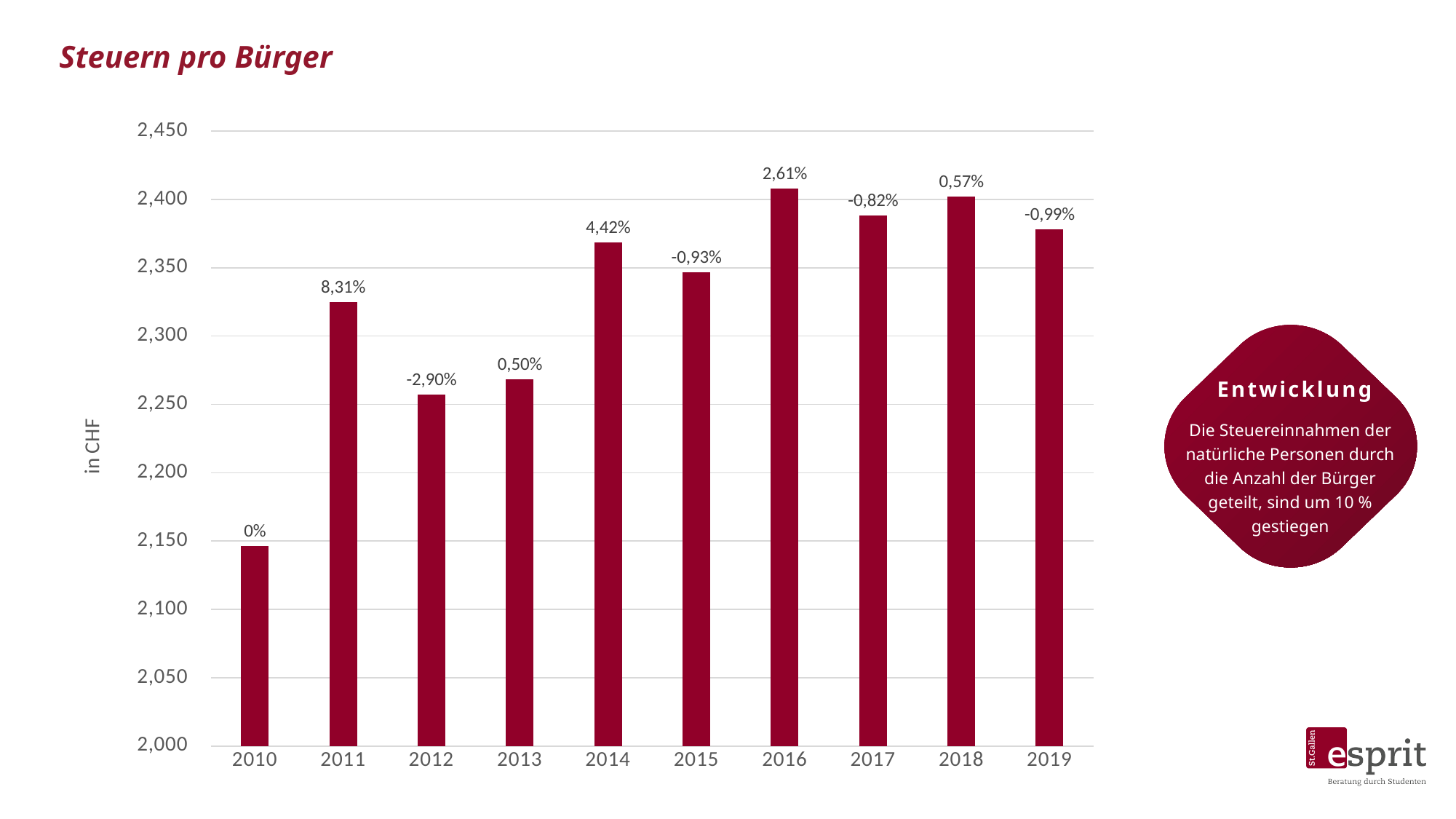
What percentage change is labelled above the bar for 2011? 8,31% Is the value for 2011 greater or less than 2,300? greater Which year has the lowest value in the chart? 2010 What is the title of the chart? Steuern pro Bürger Is the value for 2019 greater or less than 2,400? less What percentage change is labelled above the bar for 2012? -2,90% What is the unit label on the y axis of the chart? in CHF Which year has the highest percentage change label? 2011 Which year has the larger value, 2014 or 2015? 2014 What kind of chart is shown on the slide? bar chart How many years are shown on the x axis of the chart? 10 What percentage change is labelled above the bar for 2016? 2,61%